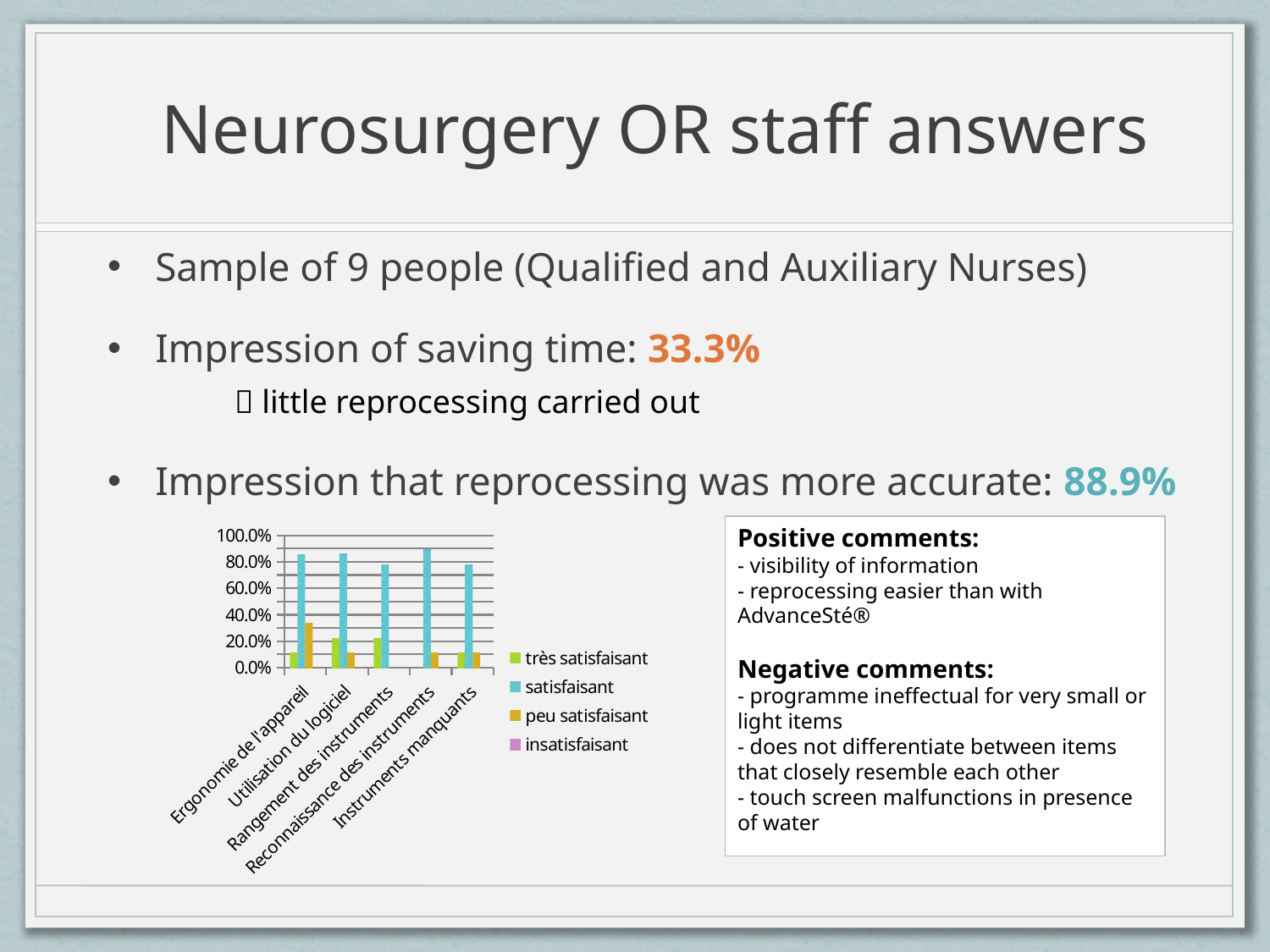
Which legend entry is shown in blue in the chart? satisfaisant What kind of chart is shown on the slide? bar chart How many categories are shown on the x axis of the chart? 5 Is the 'peu satisfaisant' value for 'Instruments manquants' greater or less than 20.0%? less What is the highest value shown on the chart's vertical axis? 100.0% Is the 'très satisfaisant' value for 'Ergonomie de l'appareil' greater or less than 20.0%? less How many series does the chart's legend list? 4 Is the 'satisfaisant' value for 'Ergonomie de l'appareil' greater or less than 80.0%? greater For 'Ergonomie de l'appareil', which is larger: the 'satisfaisant' value or the 'très satisfaisant' value? satisfaisant For 'Utilisation du logiciel', which series has the highest value? satisfaisant